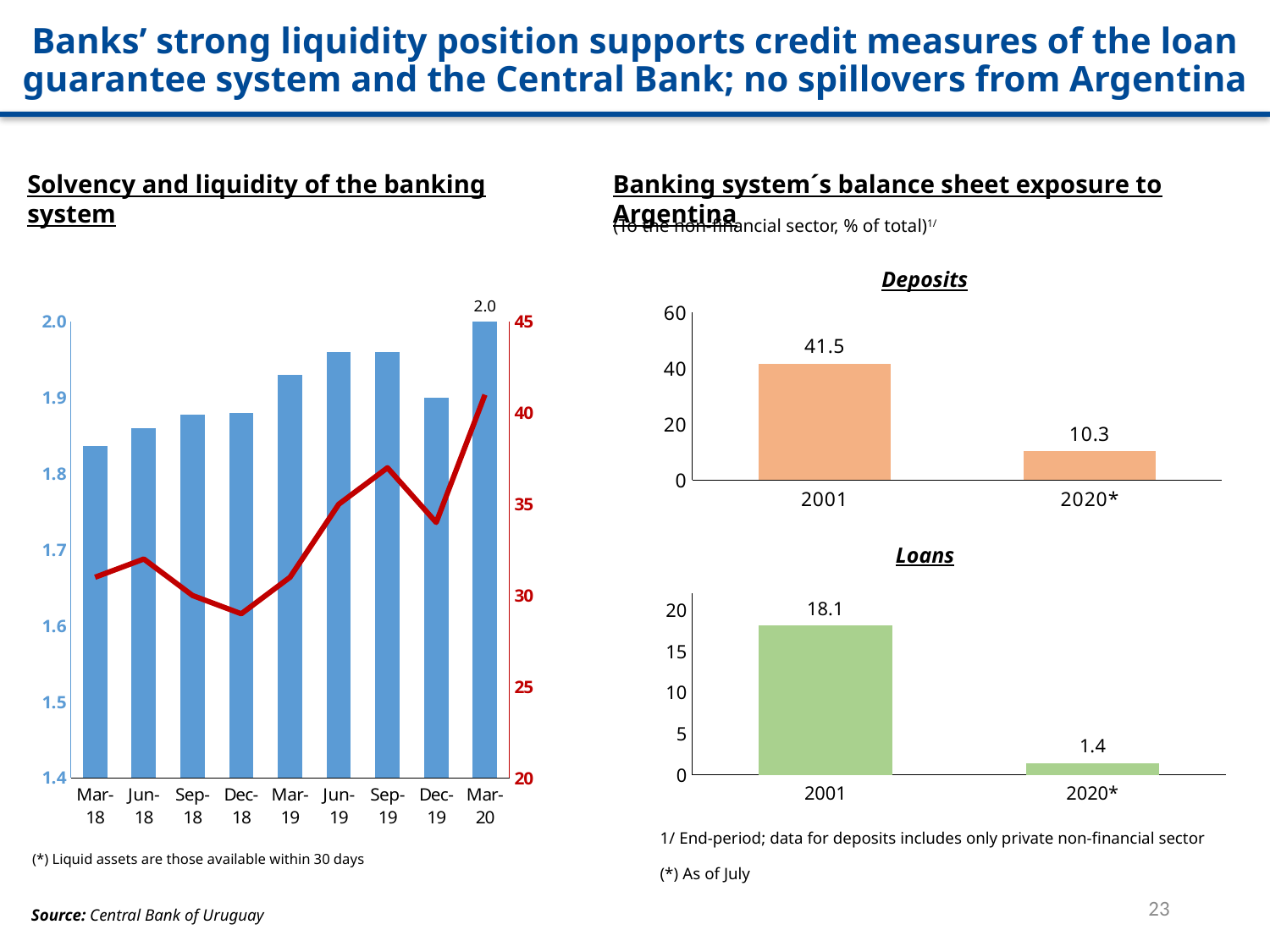
In the Loans chart, what is the value for 2020*? 1.4 In the Solvency and liquidity of the banking system chart, what is the data label shown on the bar for Mar-20? 2.0 In the Loans chart, which year has the higher value, 2001 or 2020*? 2001 In the Deposits chart, what is the value for 2001? 41.5 In the Solvency and liquidity of the banking system chart, is the bar for Mar-18 greater or less than 1.9 on the left axis? less In the Loans chart, what is the value for 2001? 18.1 In the Deposits chart, what is the value for 2020*? 10.3 In the Deposits chart, what is the difference between the 2001 and 2020* values? 31.2 In the Deposits chart, how many bars are shown? 2 In the Solvency and liquidity of the banking system chart, how many periods are shown on the x axis? 9 In the Loans chart, what is the difference between the 2001 and 2020* values? 16.7 What kind of chart is the Loans chart? bar chart